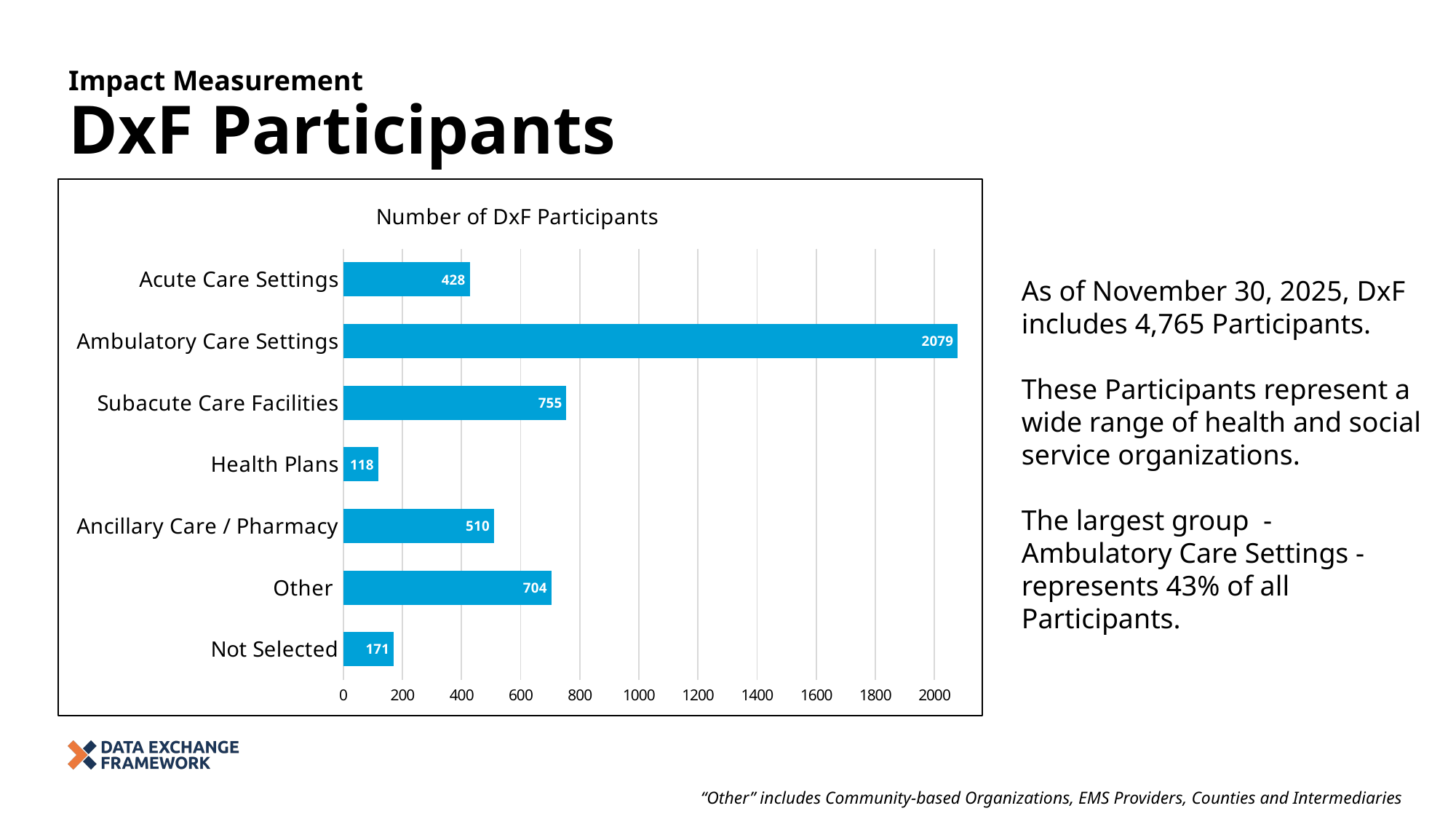
How many categories are shown in the chart? 7 Which has more participants, Ancillary Care / Pharmacy or Acute Care Settings? Ancillary Care / Pharmacy What is the difference between the number of participants in Subacute Care Facilities and Other? 51 What is the title of the chart? Number of DxF Participants Is the value for Other greater or less than 600? greater What kind of chart is shown on the slide? Bar chart Which category has the highest number of DxF Participants? Ambulatory Care Settings What is the difference between the number of participants in Acute Care Settings and Not Selected? 257 Which category has the lowest number of DxF Participants? Health Plans What is the number of DxF Participants for Health Plans? 118 What is the number of DxF Participants for Ambulatory Care Settings? 2079 What is the number of DxF Participants for Subacute Care Facilities? 755